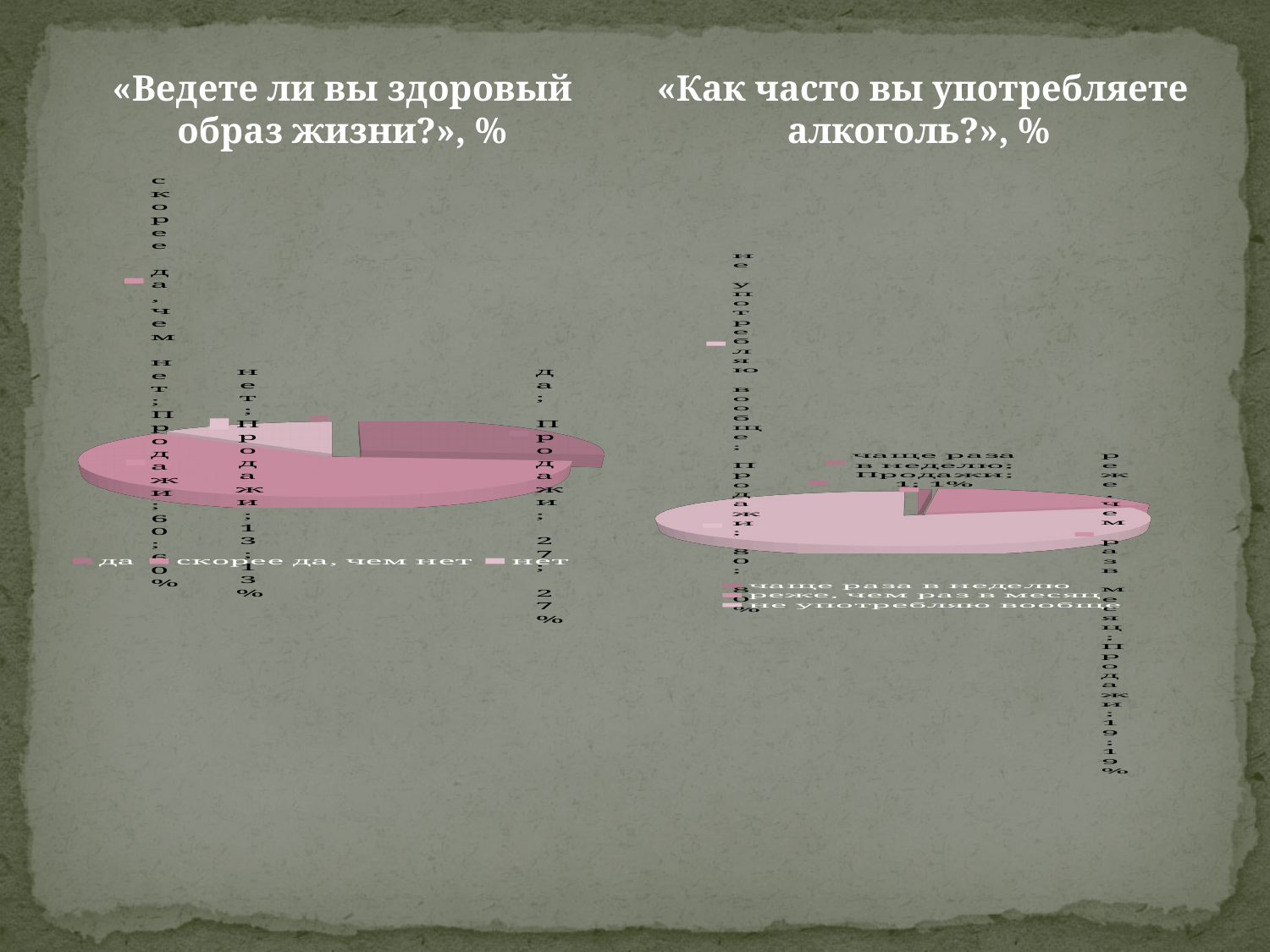
On the chart «Ведете ли вы здоровый образ жизни?», which answer has the smallest share? нет On the chart «Как часто вы употребляете алкоголь?», what percentage is shown for «не употребляю вообще»? 80% On the chart «Ведете ли вы здоровый образ жизни?», what percentage is shown for «нет»? 13% How many categories does the legend of the chart «Ведете ли вы здоровый образ жизни?» list? 3 On the chart «Ведете ли вы здоровый образ жизни?», what percentage is shown for «скорее да, чем нет»? 60% On the chart «Ведете ли вы здоровый образ жизни?», what percentage is shown for «да»? 27% On the chart «Как часто вы употребляете алкоголь?», which answer has the smallest share? чаще раза в неделю On the chart «Как часто вы употребляете алкоголь?», what percentage is shown for «чаще раза в неделю»? 1% On the chart «Как часто вы употребляете алкоголь?», what percentage is shown for «реже, чем раз в месяц»? 19% On the chart «Ведете ли вы здоровый образ жизни?», what is the difference in percentage points between «да» and «нет»? 14 On the chart «Ведете ли вы здоровый образ жизни?», which answer has the largest share? скорее да, чем нет What type of chart is used on the right side of the slide («Как часто вы употребляете алкоголь?»)? pie chart